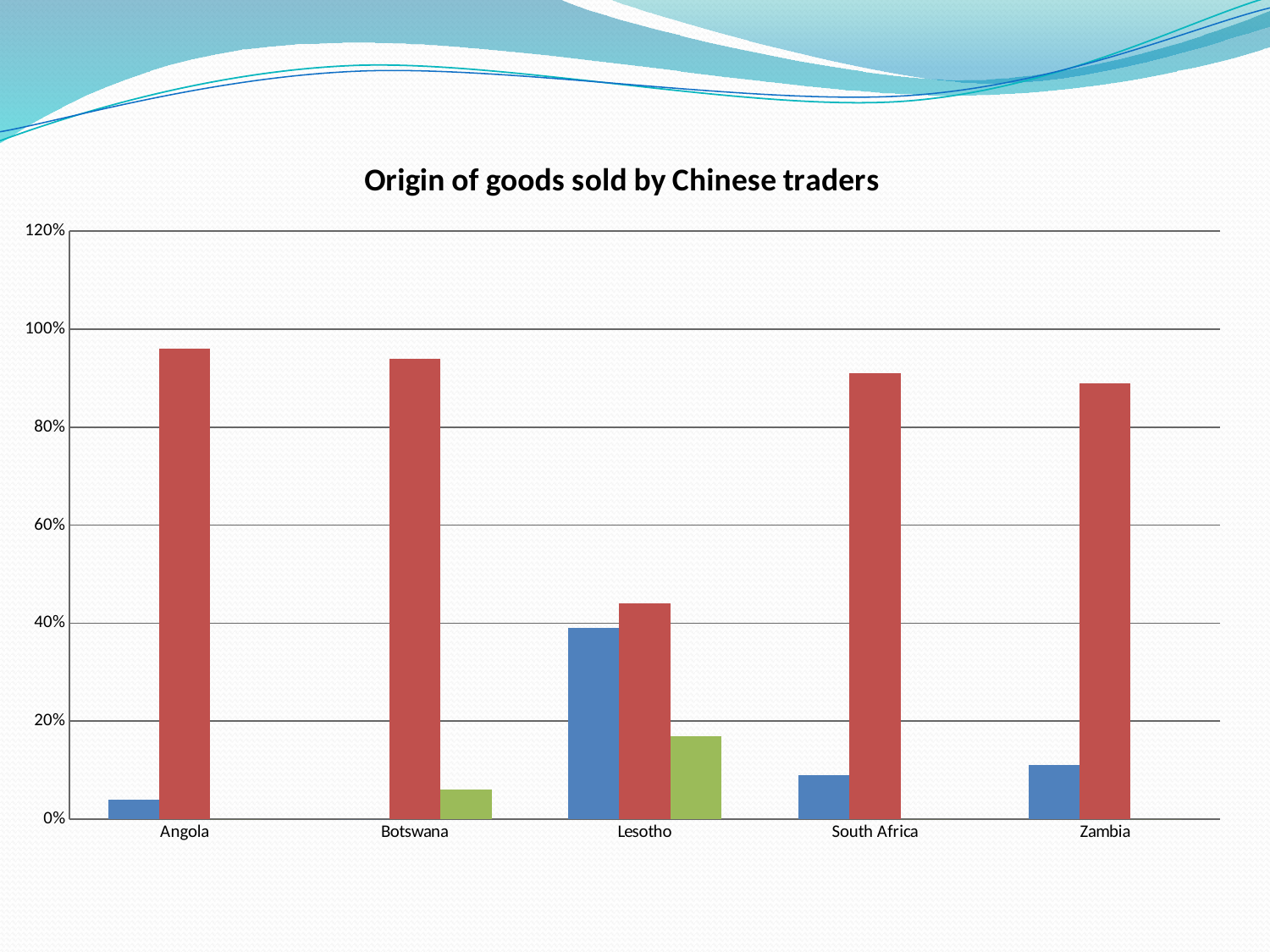
Which is larger, the red bar for Lesotho or the red bar for South Africa? South Africa Is the blue bar for Lesotho greater or less than 20%? greater Which country has the highest blue bar? Lesotho Which country has the lowest red bar? Lesotho Is the red bar for Angola greater or less than 80%? greater Which is larger, the blue bar for Lesotho or the blue bar for Zambia? Lesotho Is the red bar for Zambia greater or less than 80%? greater What is the title of the chart? Origin of goods sold by Chinese traders What kind of chart is shown on the slide? bar chart How many countries are shown on the x axis of the chart? 5